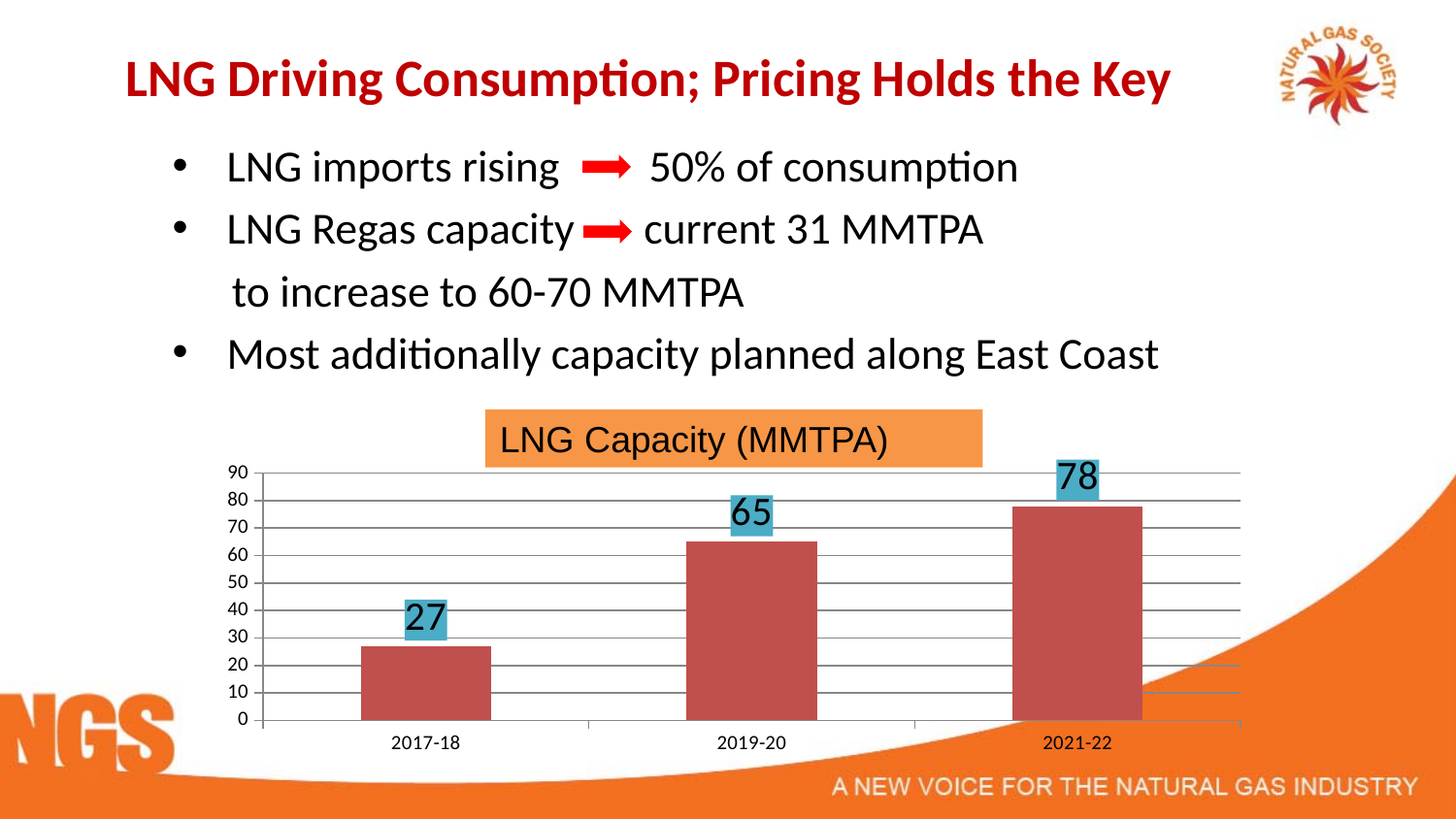
What kind of chart is shown on the slide? bar chart What is the LNG capacity value for 2021-22? 78 What is the LNG capacity value for 2017-18? 27 Which year has the highest LNG capacity? 2021-22 Is the LNG capacity for 2019-20 greater or less than 60? greater What is the difference in LNG capacity between 2021-22 and 2017-18? 51 Do the LNG capacity values rise or fall from 2017-18 to 2021-22? rise Which is larger, the LNG capacity for 2019-20 or for 2021-22? 2021-22 How many years are shown on the chart? 3 Which year has the lowest LNG capacity? 2017-18 What is the difference in LNG capacity between 2019-20 and 2017-18? 38 What is the LNG capacity value for 2019-20? 65